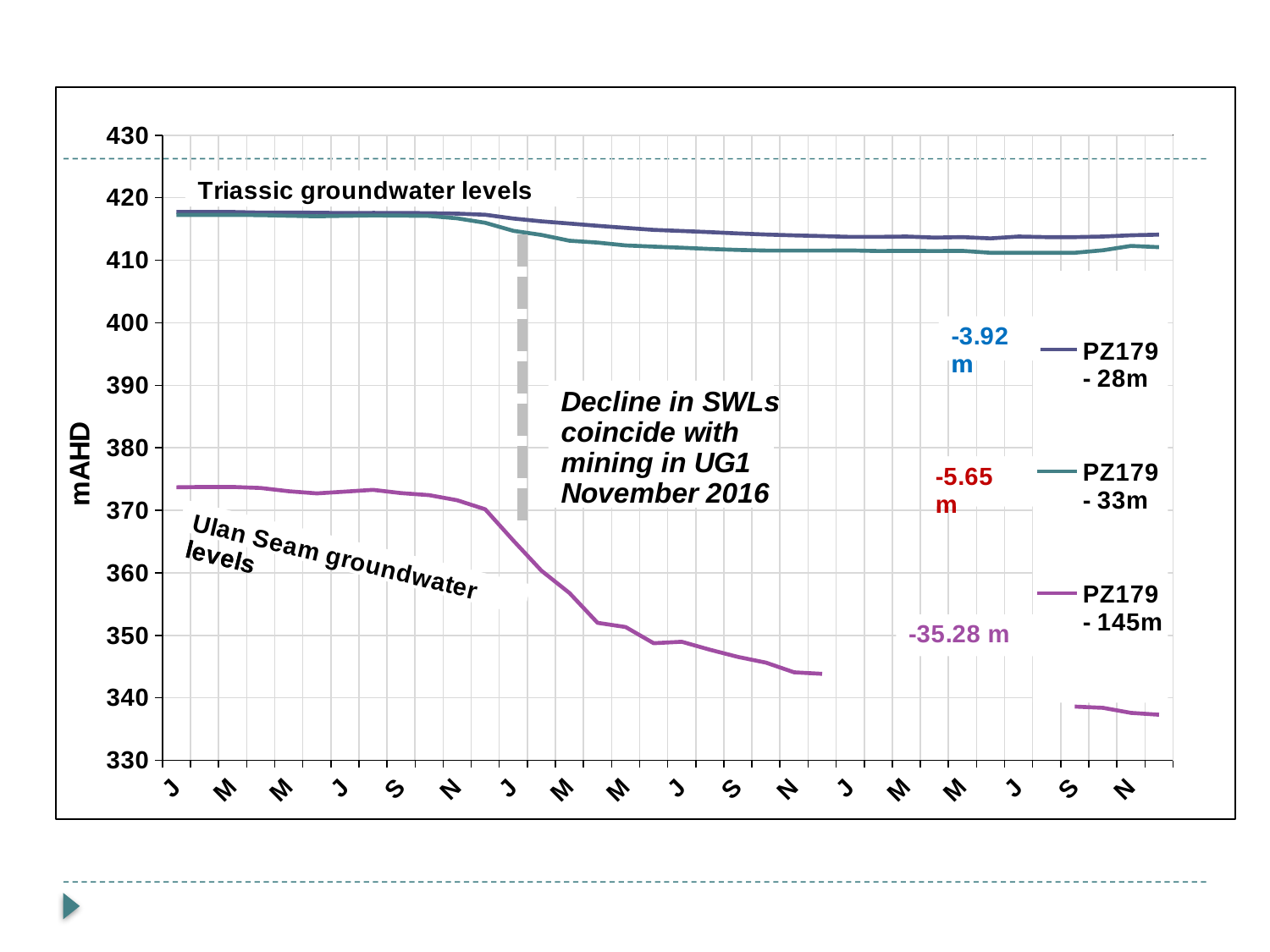
What kind of chart is shown on the slide? line chart Do the values of the PZ179 - 145m series rise or fall along the x axis? fall Which series has the lowest groundwater levels throughout the chart? PZ179 - 145m How many series does the legend list? 3 Is the first value of the PZ179 - 145m series greater or less than 370? greater Which series has the highest groundwater levels at the end of the chart? PZ179 - 28m What decline value is annotated for the PZ179 - 28m series? -3.92 m Is the last value of the PZ179 - 145m series greater or less than 340? less What is the label on the vertical axis? mAHD Which series is larger at the start of the chart, PZ179 - 28m or PZ179 - 145m? PZ179 - 28m What decline value is annotated for the PZ179 - 33m series? -5.65 m What decline value is annotated for the PZ179 - 145m series? -35.28 m